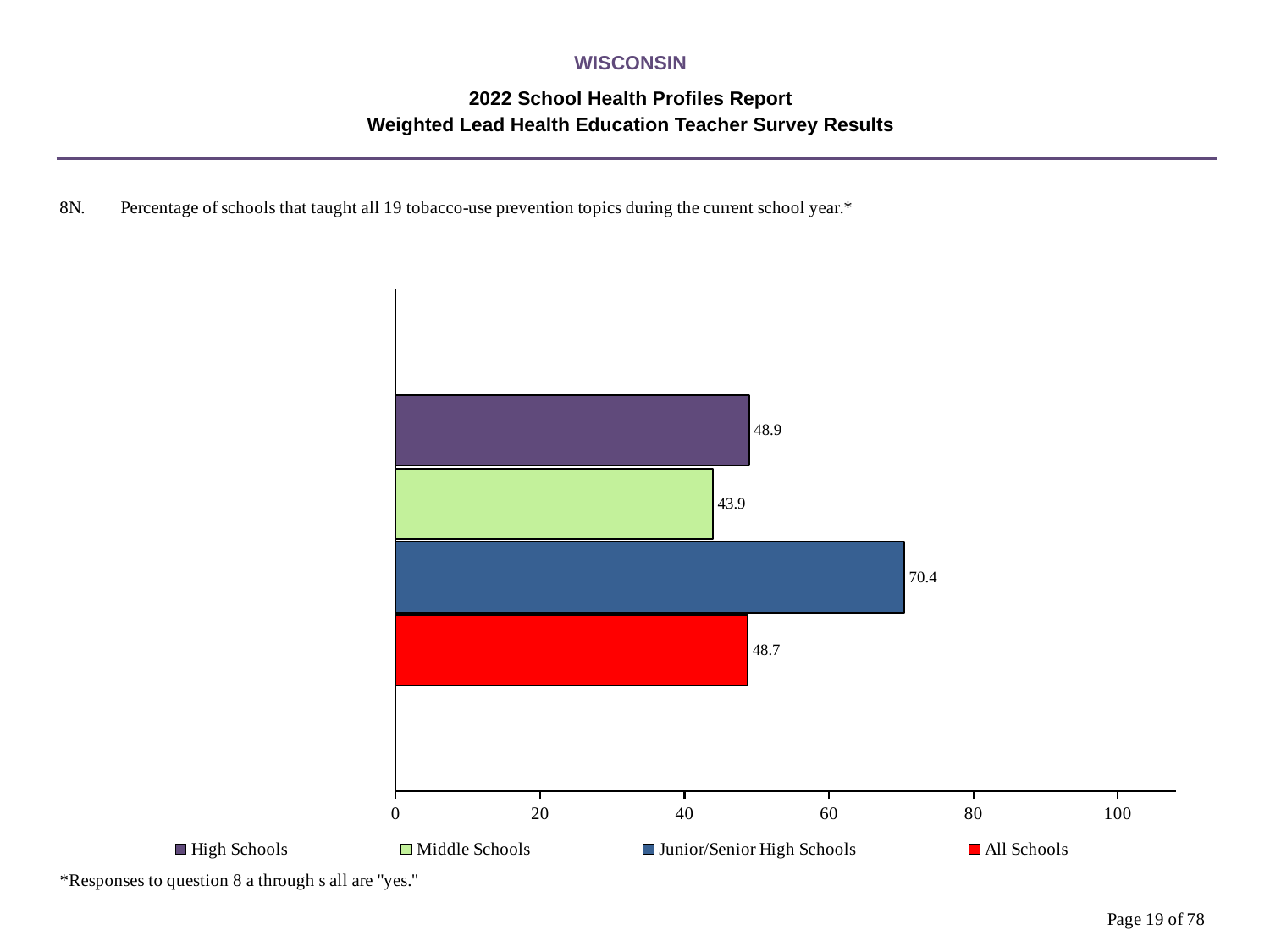
What is the value for High Schools? 48.9 Which is larger, the value for High Schools or the value for Middle Schools? High Schools Which school type has the lowest value? Middle Schools What colour is the bar for All Schools? red What is the value for Middle Schools? 43.9 What is the difference between the values for Junior/Senior High Schools and Middle Schools? 26.5 What is the value for All Schools? 48.7 How many series does the legend list? 4 What kind of chart is shown on the slide? bar chart Is the value for Junior/Senior High Schools greater or less than 60? greater Which school type has the highest value? Junior/Senior High Schools What is the value for Junior/Senior High Schools? 70.4